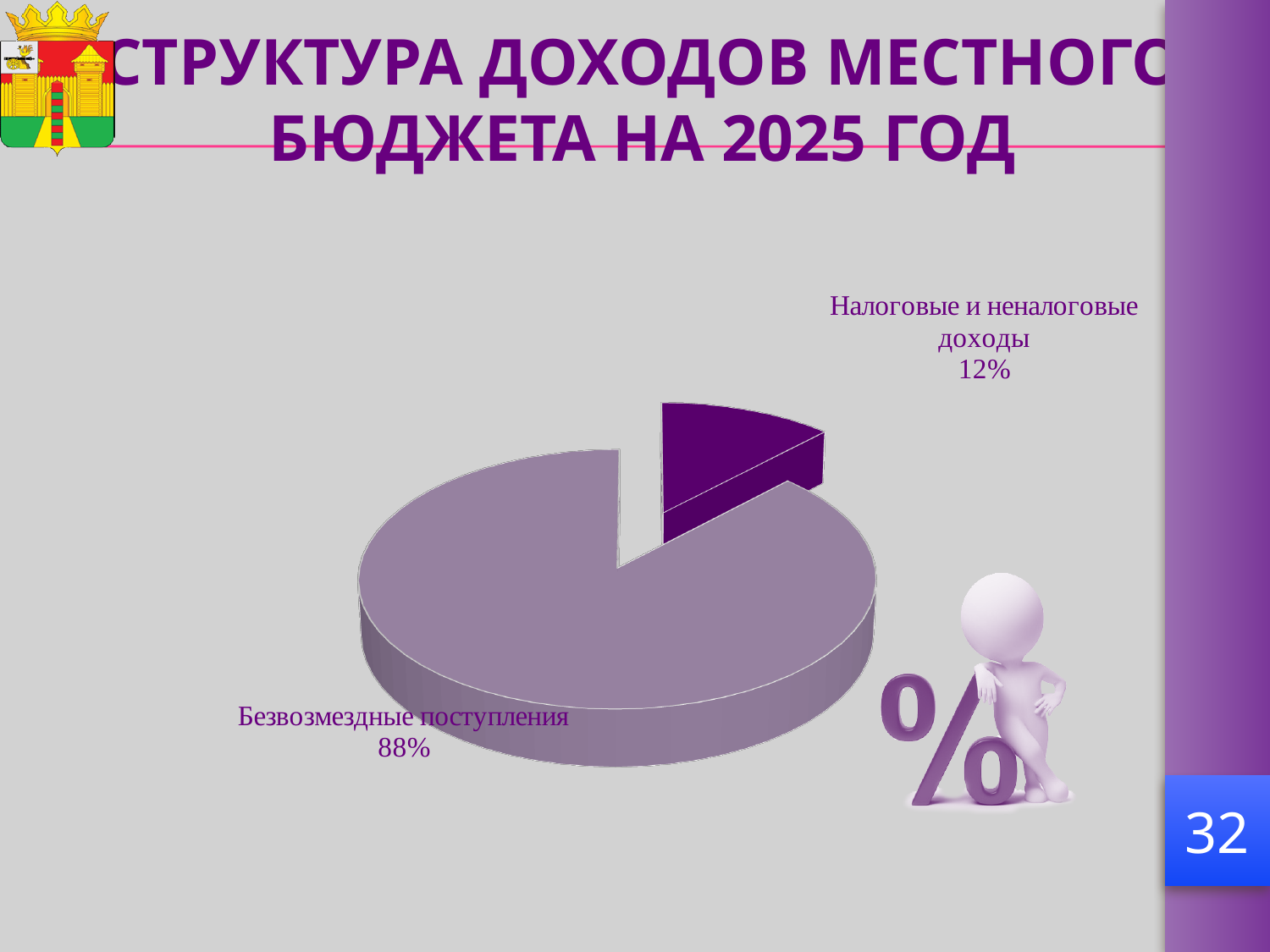
Which slice is pulled out (exploded) from the pie? Налоговые и неналоговые доходы Which is larger: Безвозмездные поступления or Налоговые и неналоговые доходы? Безвозмездные поступления How many categories are shown in the pie chart? 2 What kind of chart is shown on the slide? Pie chart What is the title of the slide containing the chart? СТРУКТУРА ДОХОДОВ МЕСТНОГО БЮДЖЕТА НА 2025 ГОД What share of the pie does Безвозмездные поступления have? 88% What is the difference in percentage points between Безвозмездные поступления and Налоговые и неналоговые доходы? 76 Which category has the largest slice of the pie? Безвозмездные поступления What share of the pie does Налоговые и неналоговые доходы have? 12% Which category has the smallest slice of the pie? Налоговые и неналоговые доходы